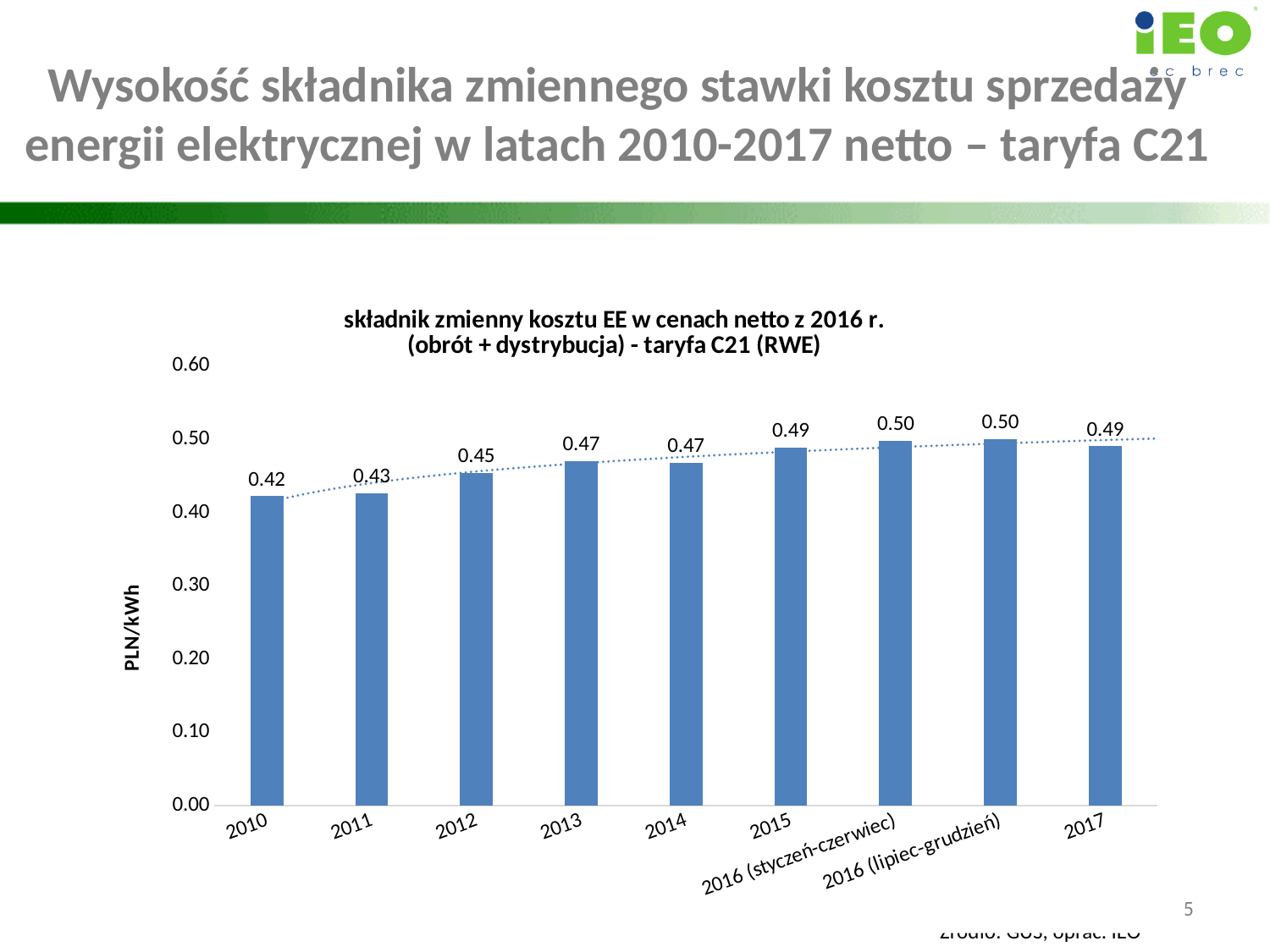
Do the values generally rise or fall from 2010 to 2016 (lipiec-grudzień)? rise What is the difference between the values for 2017 and 2010? 0.07 What is the value for 2013? 0.47 Which category has the lowest value? 2010 What is the value for 2016 (styczeń-czerwiec)? 0.50 Which is larger, the value for 2015 or the value for 2011? 2015 What unit is shown on the y axis label? PLN/kWh What is the value for 2010? 0.42 What kind of chart is this? bar chart What is the value for 2017? 0.49 Is the value for 2010 greater or less than 0.50? less How many categories are shown on the x axis? 9